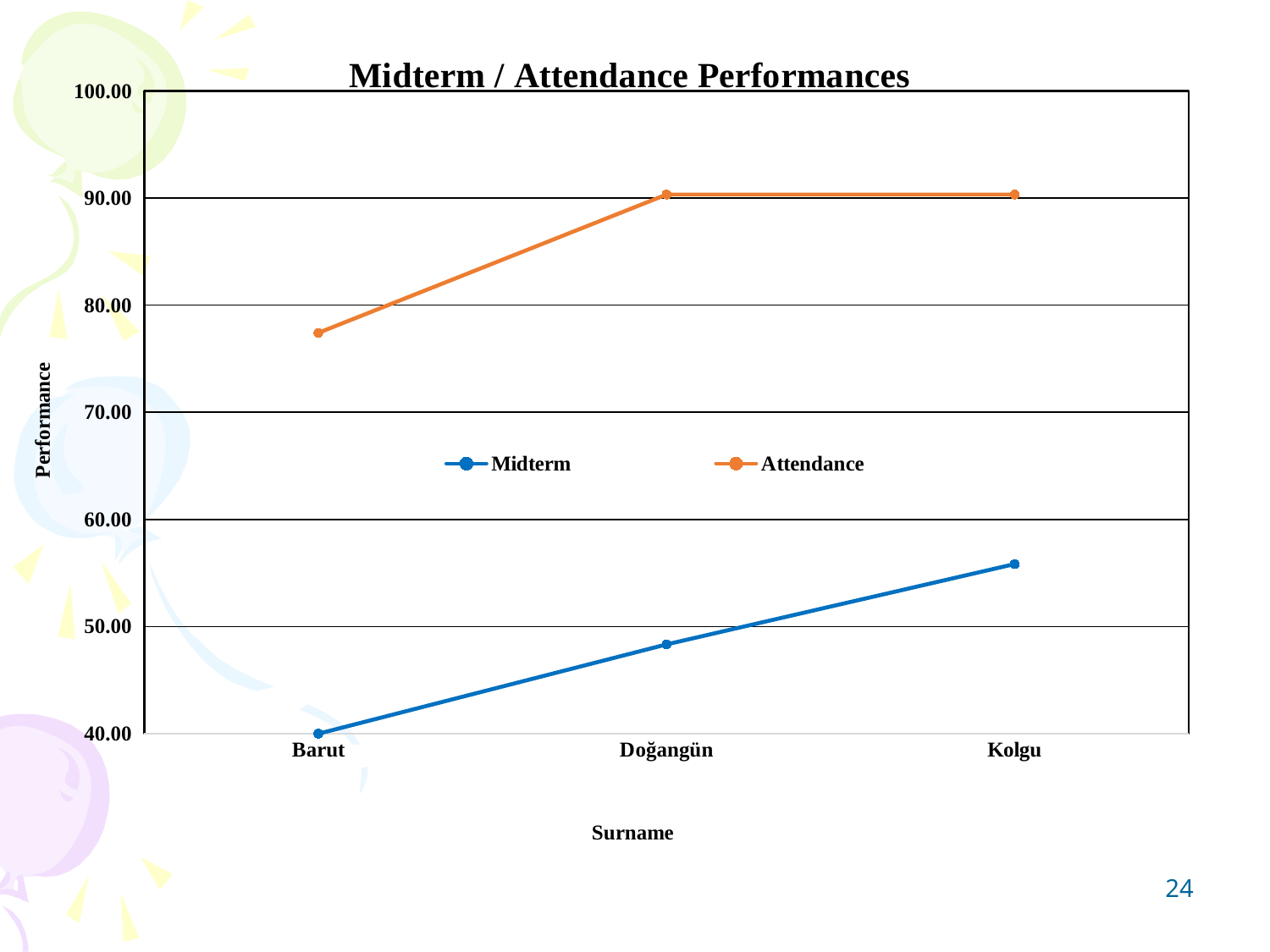
How many surnames are plotted along the x axis? 3 Which surname has the lowest Midterm value? Barut What is the title of the chart? Midterm / Attendance Performances Do the Midterm values rise or fall from Barut to Kolgu along the x axis? rise For Barut, which is larger: the Midterm value or the Attendance value? Attendance Is the Midterm value for Kolgu greater or less than 50.00? greater Which surname has the highest Midterm value? Kolgu How many series does the legend list? 2 Which surname has the lowest Attendance value? Barut What kind of chart is shown on the slide? line chart Is the Midterm value for Doğangün greater or less than 50.00? less Is the Attendance value for Barut greater or less than 80.00? less